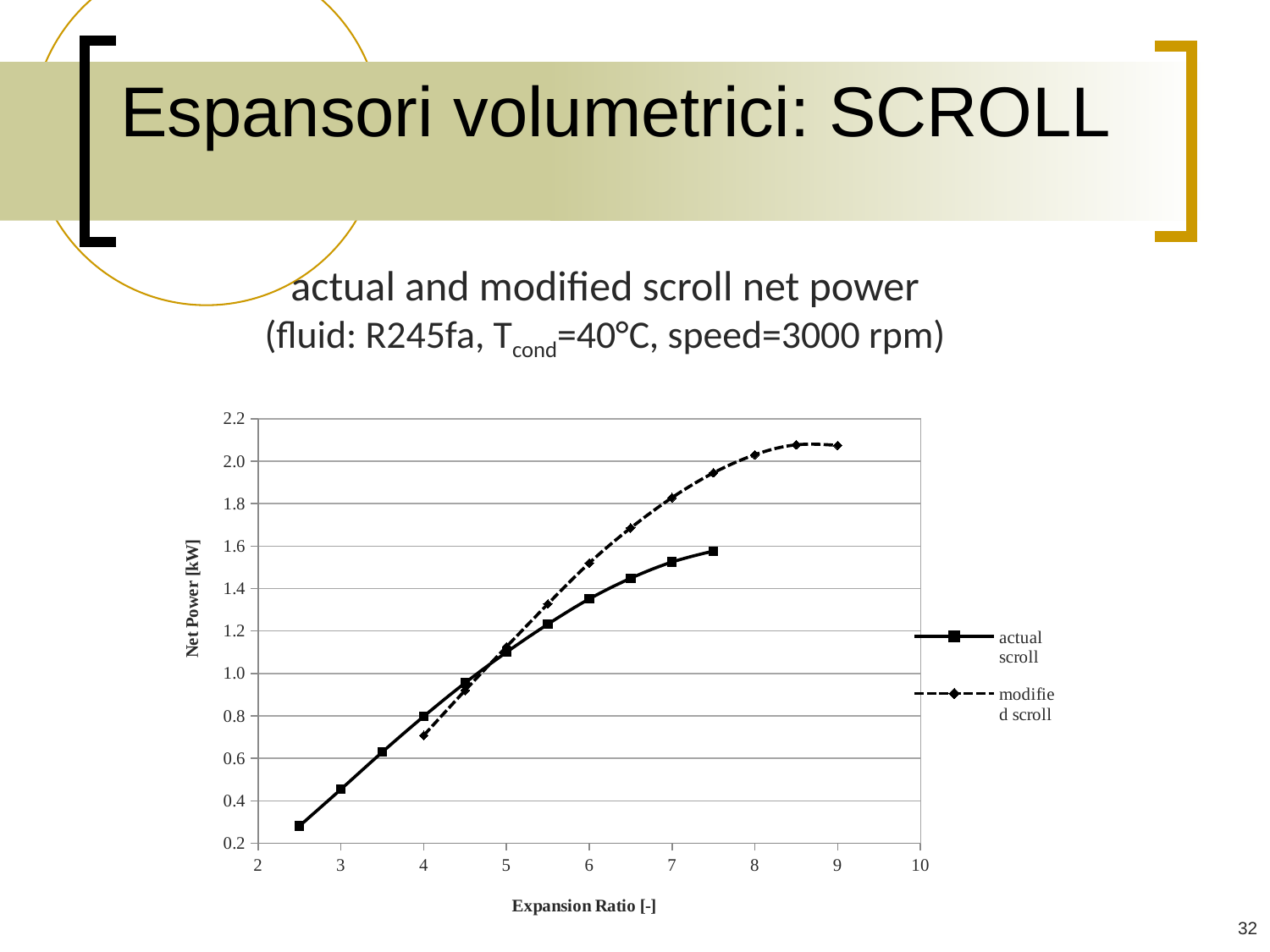
Which series reaches the highest net power on the chart? modified scroll At an expansion ratio of 7, which series has the larger net power, actual scroll or modified scroll? modified scroll Is the net power of the modified scroll at an expansion ratio of 4 greater or less than 0.8 kW? less At an expansion ratio of 4, which series has the larger net power, actual scroll or modified scroll? actual scroll How many data points are plotted for the actual scroll series? 11 What kind of chart is shown on the slide? line chart Does the net power of the actual scroll rise or fall as the expansion ratio increases? rise How many series does the legend list? 2 Is the net power of the modified scroll at an expansion ratio of 9 greater or less than 2.0 kW? greater What is the label of the x axis? Expansion Ratio [-] What are the two series named in the legend? actual scroll, modified scroll Is the net power of the actual scroll at an expansion ratio of 3 greater or less than 0.6 kW? less